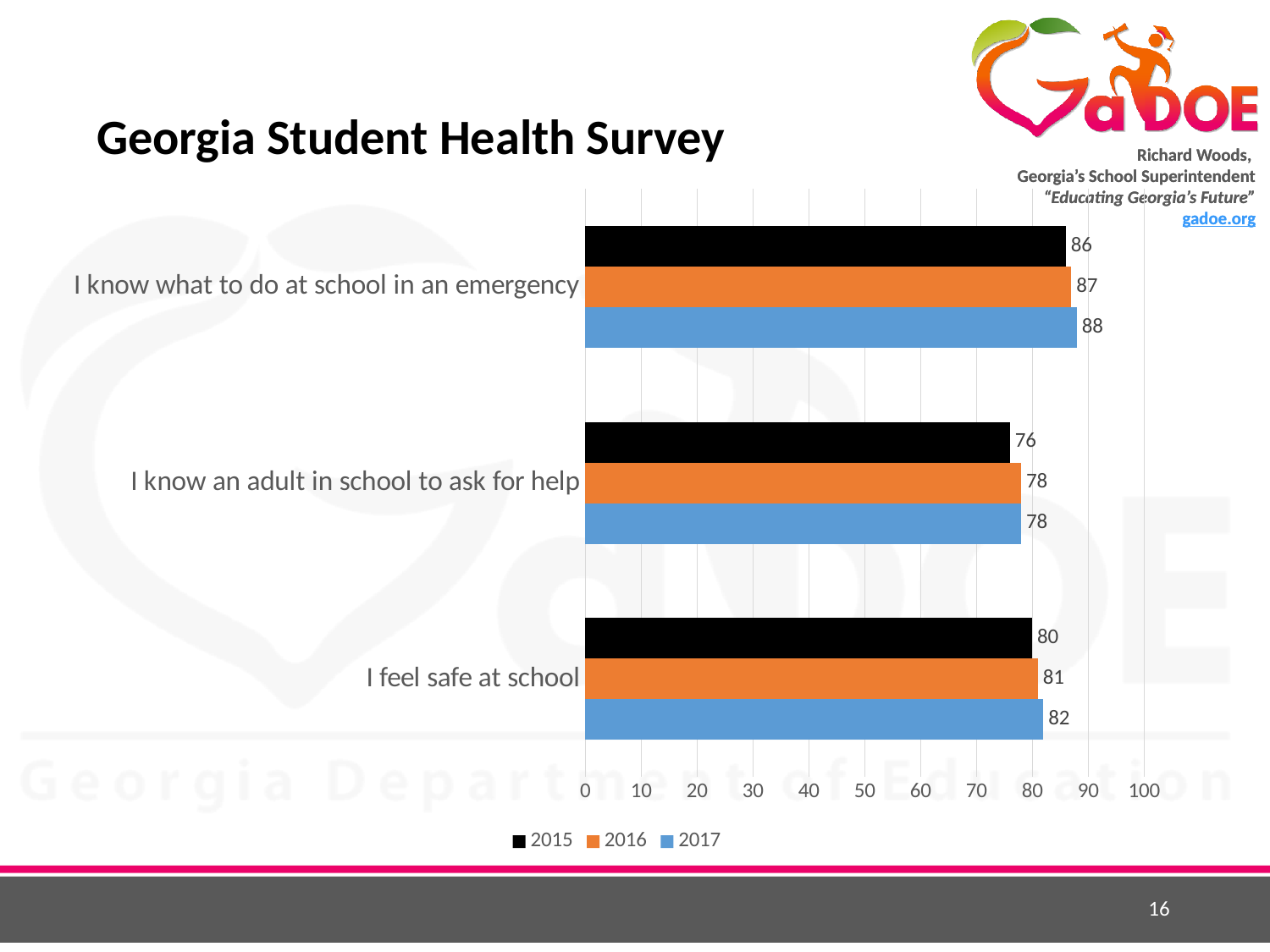
What is the difference between the 2017 and 2015 values for "I feel safe at school"? 2 What is the 2016 value for "I feel safe at school"? 81 What is the 2017 value for "I know what to do at school in an emergency"? 88 Which series is shown in orange? 2016 How many categories are shown on the chart? 3 Do the values for "I feel safe at school" rise or fall from 2015 to 2017? Rise Which category has the highest 2017 value? I know what to do at school in an emergency How many series does the legend list? 3 Which category has the lowest 2015 value? I know an adult in school to ask for help What kind of chart is shown on the slide? Bar chart What is the 2015 value for "I know an adult in school to ask for help"? 76 Which is larger: the 2016 value for "I know what to do at school in an emergency" or the 2016 value for "I feel safe at school"? I know what to do at school in an emergency